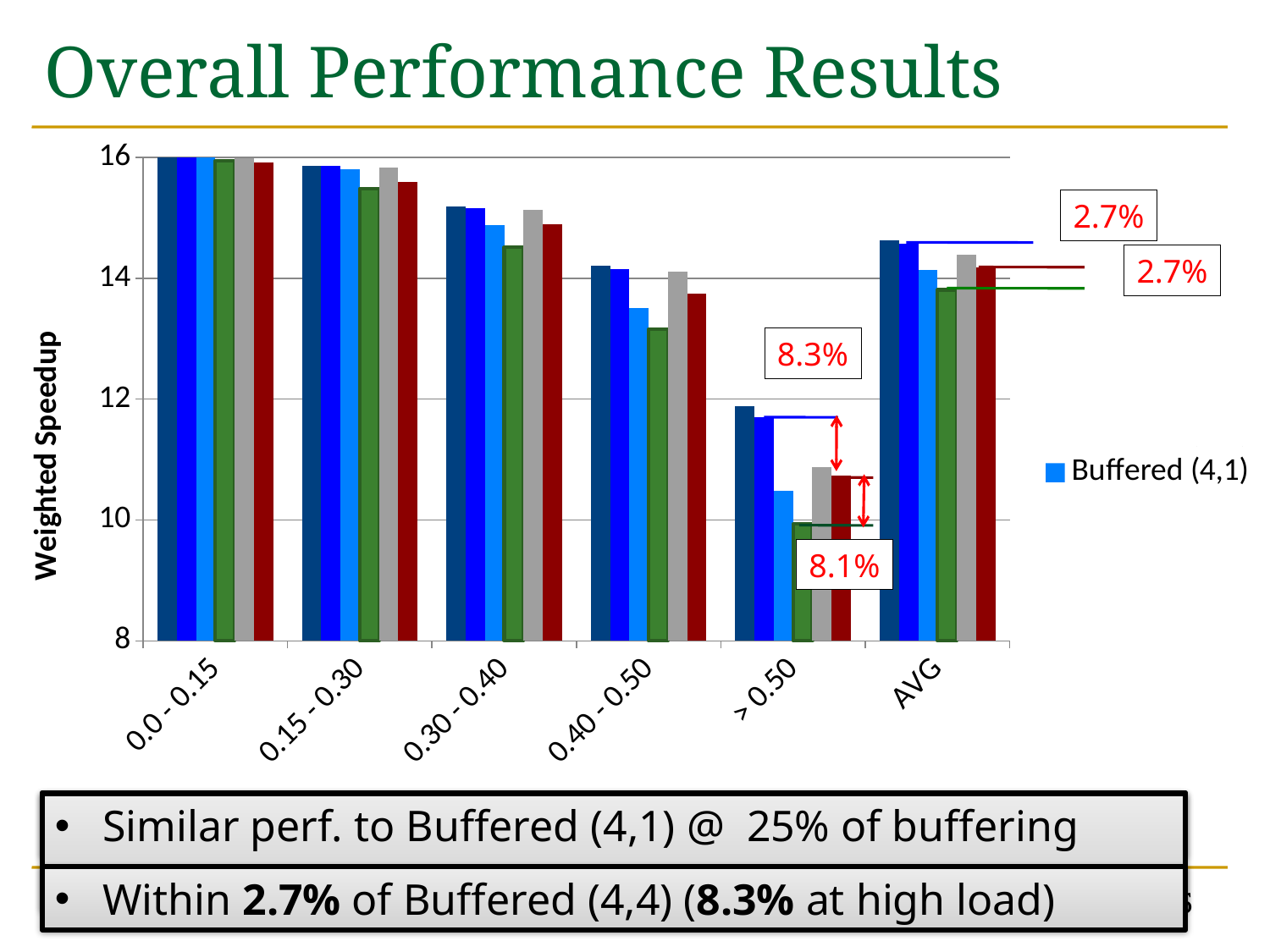
Is the Buffered (4,1) value for the 0.0 - 0.15 category greater or less than 14? greater In which category does the Buffered (4,1) series have its lowest value? > 0.50 How many categories are shown on the x axis of the chart? 6 Is the Buffered (4,1) value larger for 0.0 - 0.15 or for > 0.50? 0.0 - 0.15 Is the Buffered (4,1) value for the > 0.50 category greater or less than 12? less What percentage is annotated above the > 0.50 category group in the chart? 8.3% Is the Buffered (4,1) value for the 0.40 - 0.50 category greater or less than 14? less What kind of chart is shown on the slide? bar chart Which series name is readable in the chart's legend? Buffered (4,1) How many bars are plotted in each category group of the chart? 6 What is the label of the y axis of the chart? Weighted Speedup Do the weighted speedup values rise or fall from the 0.0 - 0.15 category to the > 0.50 category? fall